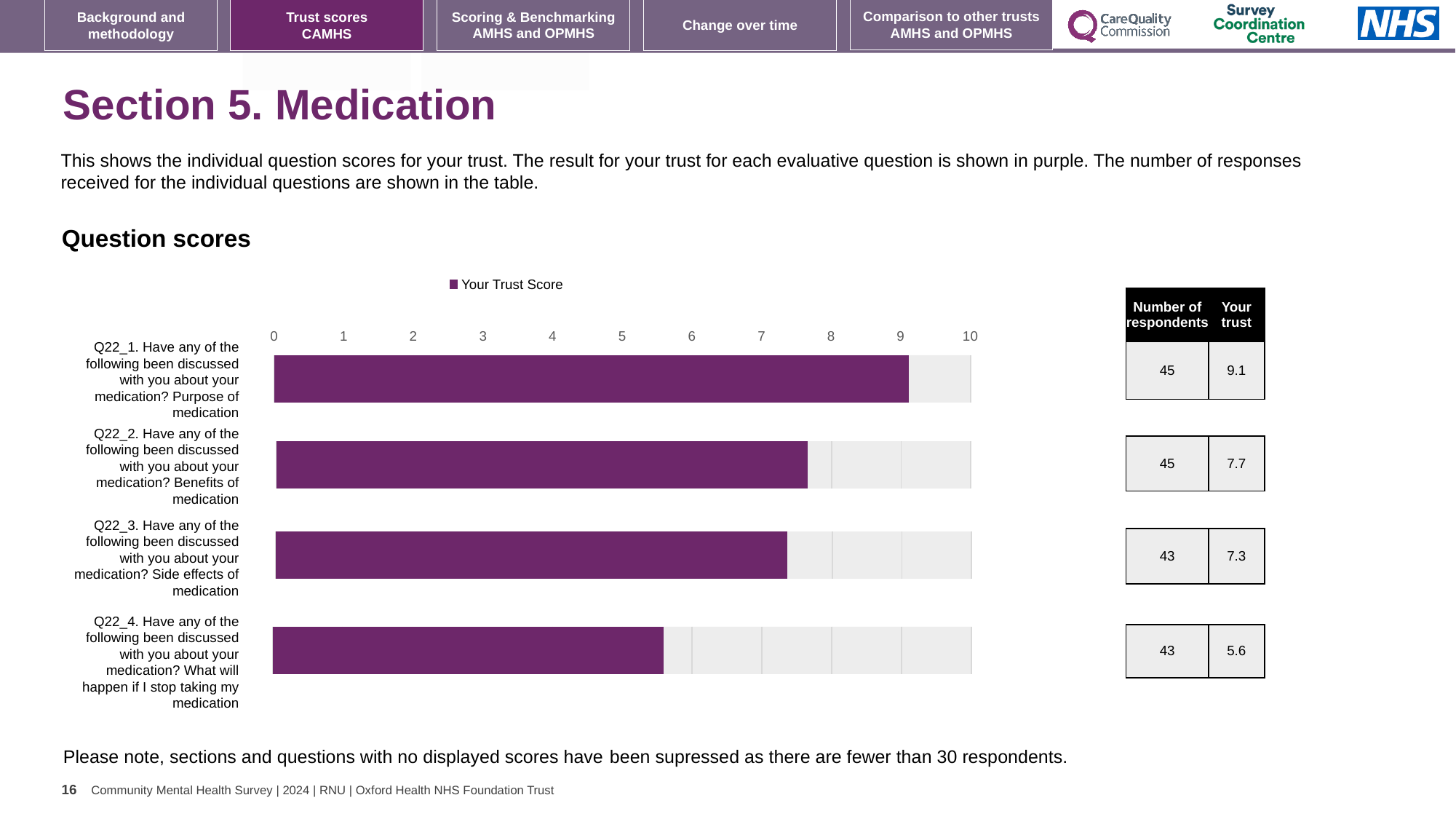
Is the trust score for Q22_2 (Benefits of medication) greater or less than 7? greater How many series does the legend list? 1 What is the difference between the trust scores for Q22_1 and Q22_4? 3.5 What is the trust score for Q22_1 (Purpose of medication)? 9.1 What is the trust score for Q22_3 (Side effects of medication)? 7.3 What is the name of the series shown in the legend? Your Trust Score Which question has the highest trust score? Q22_1. Purpose of medication Which has a higher trust score, Q22_2 (Benefits of medication) or Q22_3 (Side effects of medication)? Q22_2. Benefits of medication What type of chart is shown on the slide? Bar chart Which question has the lowest trust score? Q22_4. What will happen if I stop taking my medication How many questions are plotted in the chart? 4 What is the trust score for Q22_4 (What will happen if I stop taking my medication)? 5.6